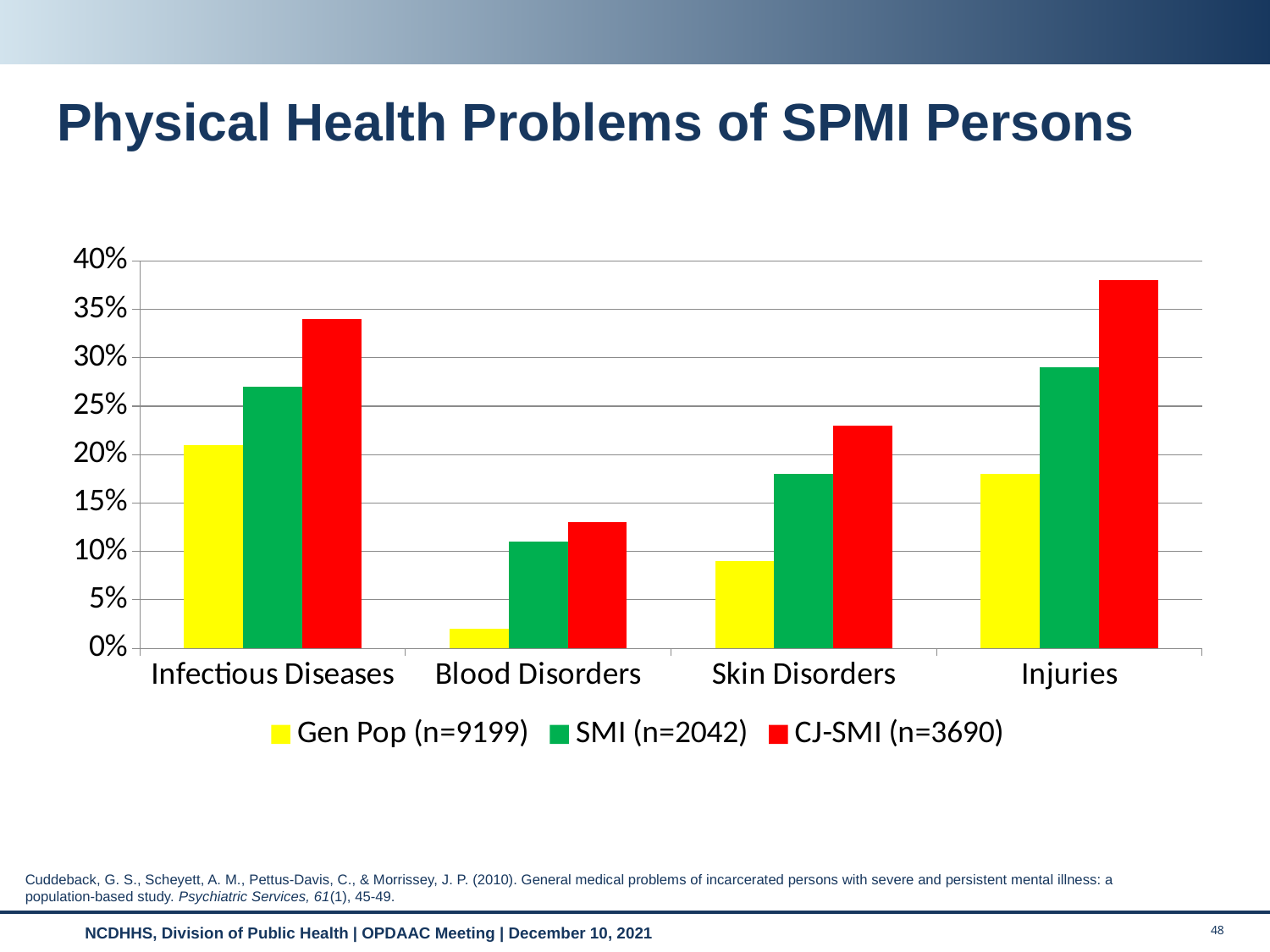
What is the title of the slide containing the chart? Physical Health Problems of SPMI Persons Which series is shown in red in the chart? CJ-SMI (n=3690) Is the Gen Pop (n=9199) value for Skin Disorders greater or less than 10%? less Is the SMI (n=2042) value for Infectious Diseases greater or less than 25%? greater What kind of chart is shown on the slide? bar chart Is the Gen Pop (n=9199) value for Blood Disorders greater or less than 5%? less How many categories are shown on the x axis of the chart? 4 Which category has the highest CJ-SMI (n=3690) value? Injuries Which category has the lowest Gen Pop (n=9199) value? Blood Disorders How many series does the chart's legend list? 3 For Skin Disorders, which is larger: the SMI (n=2042) value or the CJ-SMI (n=3690) value? CJ-SMI (n=3690)